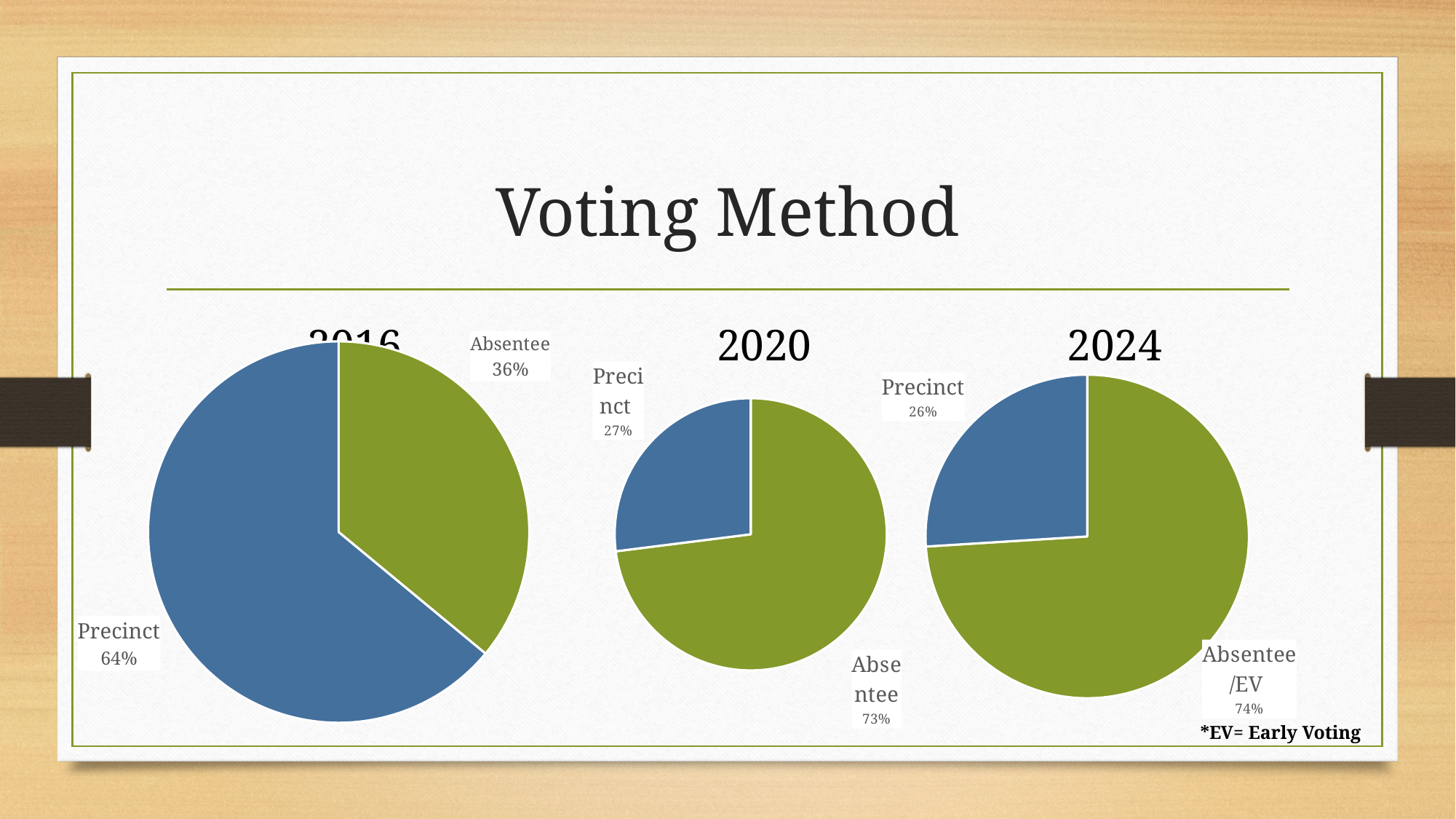
In the 2020 pie chart, what share of voters used the Absentee method? 73% In the 2024 pie chart, which voting method has the smallest share? Precinct How many pie charts are shown on the slide? 3 In the 2016 pie chart, what is the difference between the Precinct and Absentee shares? 28% In the 2016 pie chart, what share of voters used the Precinct method? 64% In the 2016 pie chart, which voting method has the largest share? Precinct What kind of chart is used to show the voting method for each year? Pie chart Which is larger: the Precinct share in 2016 or the Precinct share in 2020? Precinct share in 2016 In the 2020 pie chart, what share of voters used the Precinct method? 27% In the 2024 pie chart, what share of voters used the Precinct method? 26% In the 2016 pie chart, what share of voters used the Absentee method? 36% In the 2024 pie chart, what share of voters used the Absentee/EV method? 74%